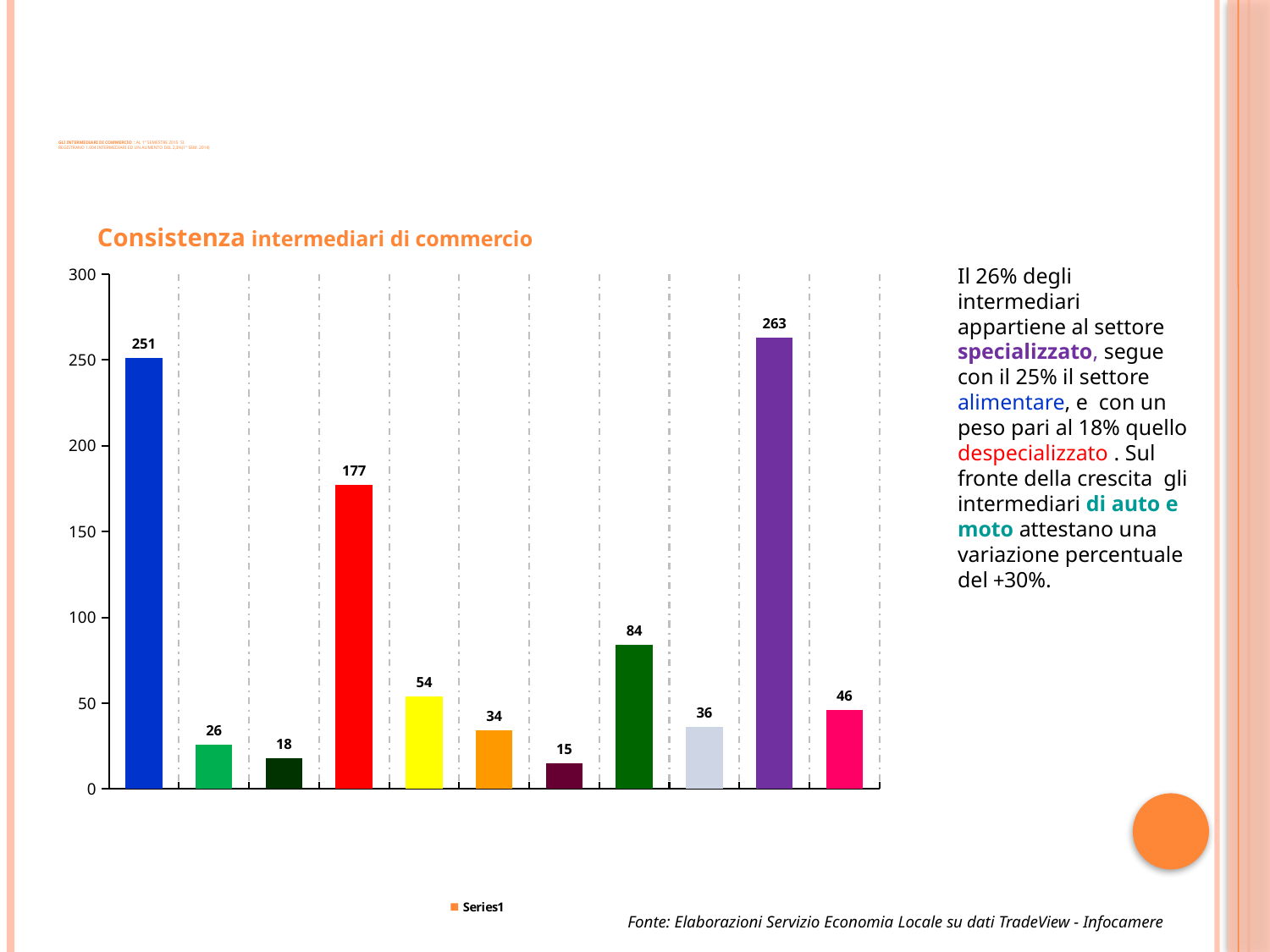
How many series does the legend list? 1 What is the value of the tallest bar in the chart? 263 What is the value of the shortest bar in the chart? 15 What is the value of the dark green bar (eighth from the left)? 84 What is the title of the chart? Consistenza intermediari di commercio What is the difference between the tallest bar (263) and the first blue bar (251)? 12 How many bars are plotted in the chart? 11 Which is larger: the yellow bar (54) or the orange bar (34)? the yellow bar (54) Is the value of the last (pink) bar on the right greater or less than 50? less What type of chart is shown on the slide? bar chart What is the value of the red bar (fourth from the left)? 177 What is the value of the first (blue) bar on the left? 251